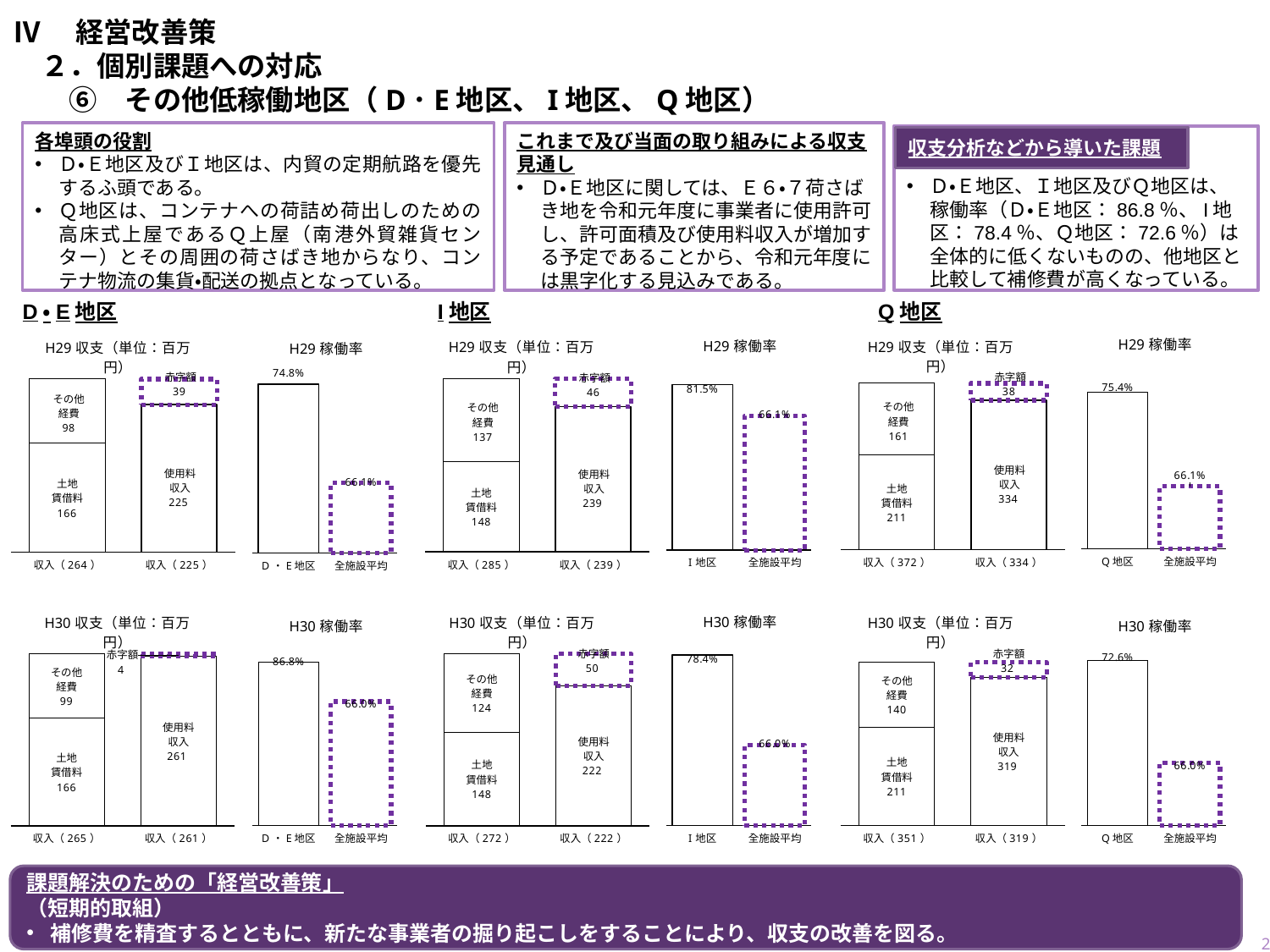
In the I地区 H30 収支 chart, what is the 赤字額? 50 In the Q地区 H29 収支 chart, what is the difference between 収入 (372) and 使用料収入 (334)? 38 In the Q地区 H30 収支 chart, what is the value of 土地賃借料? 211 In the Q地区 H30 稼働率 chart, what is the value for Q地区? 72.6% In the I地区 H29 稼働率 chart, which is larger, I地区 or 全施設平均? I地区 In the I地区 H29 稼働率 chart, what is the value for I地区? 81.5% In the I地区 H30 収支 chart, what is the total of the left stacked bar (その他経費 plus 土地賃借料)? 272 In the D・E地区 H29 収支 chart, what is the value of 使用料収入? 225 In the D・E地区 H30 収支 chart, what is the value of その他経費? 99 In the D・E地区 H30 稼働率 chart, what is the value for D・E地区? 86.8% In the D・E地区 H29 収支 chart, what is the 赤字額? 39 What kind of chart is the D・E地区 H29 稼働率 chart? bar chart